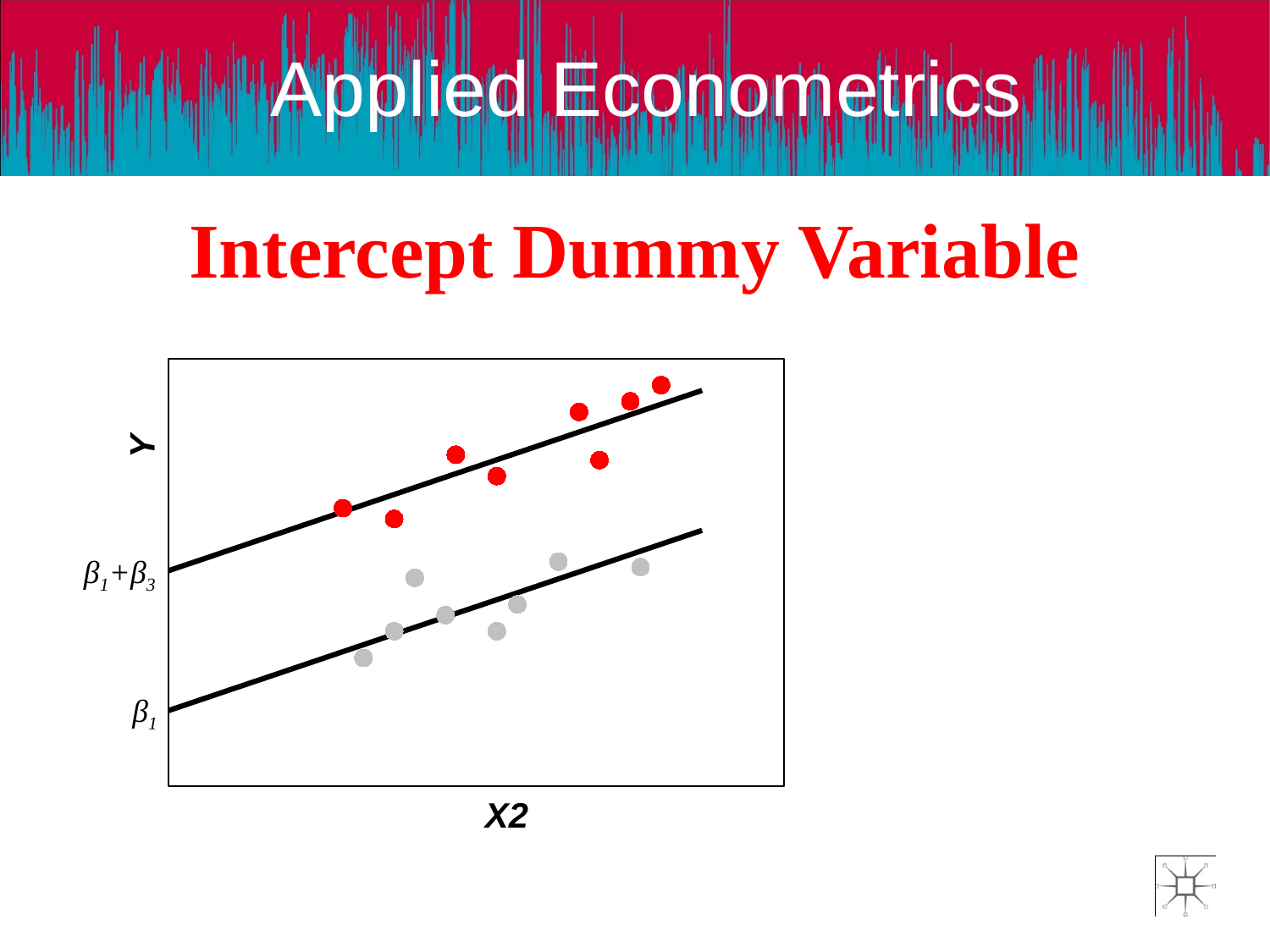
Do the values of Y rise or fall as X2 increases along the upper line? Rise What intercept label is shown for the lower line? β1 How many red data points are plotted on the chart? 8 How many fitted lines are drawn on the chart? 2 What intercept label is shown for the upper line? β1+β3 What kind of chart is shown on the slide? Scatter plot Do the values of Y rise or fall as X2 increases along the lower line? Rise What is the label on the vertical axis of the chart? Y How many grey data points are plotted on the chart? 8 What is the label on the horizontal axis of the chart? X2 Which line has the larger intercept, the one labelled β1+β3 or the one labelled β1? β1+β3 Which group of points lies higher on the chart, the red points or the grey points? Red points